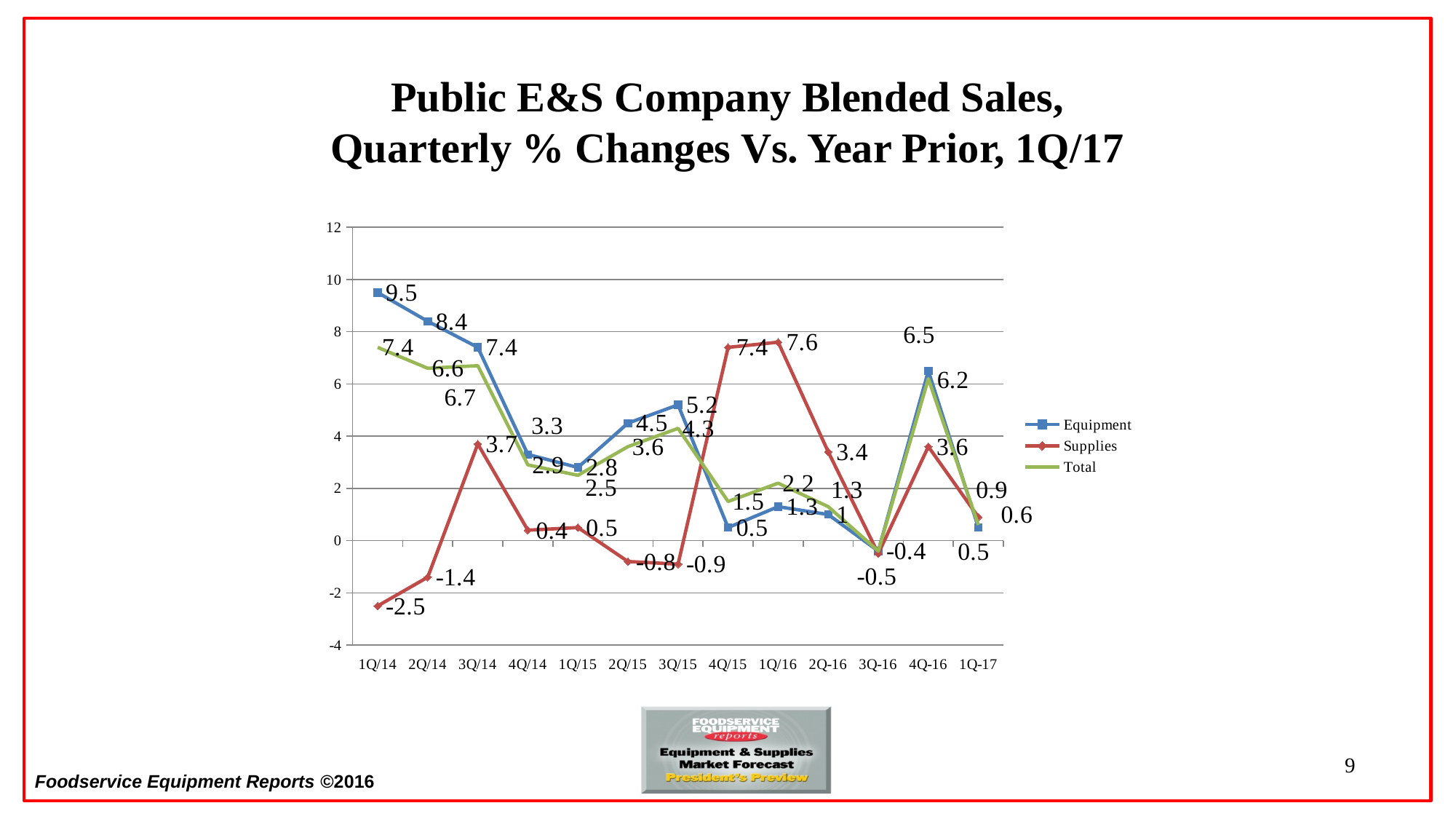
What is the difference between the Equipment value and the Supplies value in 1Q/14? 12 What is the Equipment value for 1Q/14? 9.5 Does the Equipment series rise or fall from 1Q/14 to 4Q/14? fall In which quarter is the Equipment series at its highest? 1Q/14 In which quarter is the Supplies series at its lowest? 1Q/14 How many quarters are plotted along the x axis? 13 What is the Supplies value for 1Q/16? 7.6 What is the Supplies value for 1Q/14? -2.5 What is the Total value for 4Q-16? 6.2 What kind of chart is shown on the slide? line chart How many series does the legend list? 3 Which is larger in 4Q/15, the Equipment value or the Supplies value? Supplies